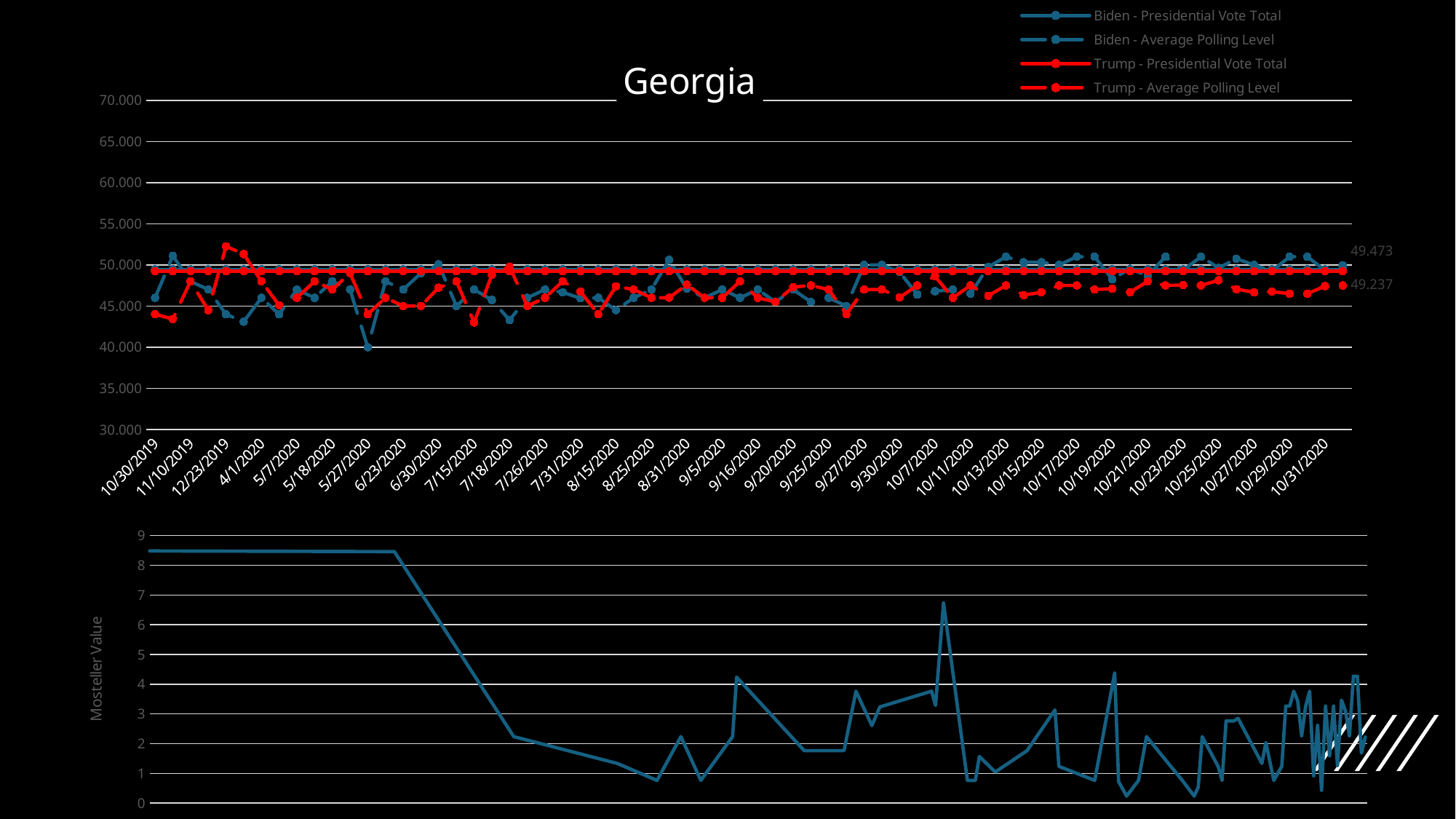
On the top chart titled Georgia, what is the difference between the Biden Presidential Vote Total (49.473) and the Trump Presidential Vote Total (49.237)? 0.236 How many series does the legend of the top chart titled Georgia list? 4 What kind of chart is the top chart titled Georgia? Line chart On the top chart titled Georgia, what colour are the Trump series lines? Red On the top chart titled Georgia, which is larger: the Biden Presidential Vote Total or the Trump Presidential Vote Total? Biden - Presidential Vote Total On the top chart titled Georgia, is the Trump - Average Polling Level value at 12/23/2019 greater or less than 50.000? greater On the bottom chart, is the first plotted Mosteller Value greater or less than 8? greater On the bottom chart, does the Mosteller Value overall rise or fall from left to right? fall On the top chart titled Georgia, is the Biden - Average Polling Level value at 5/27/2020 greater or less than 45.000? less What is the y-axis title of the bottom chart? Mosteller Value On the top chart titled Georgia, what value is labelled for the Biden - Presidential Vote Total line? 49.473 On the top chart titled Georgia, what value is labelled for the Trump - Presidential Vote Total line? 49.237